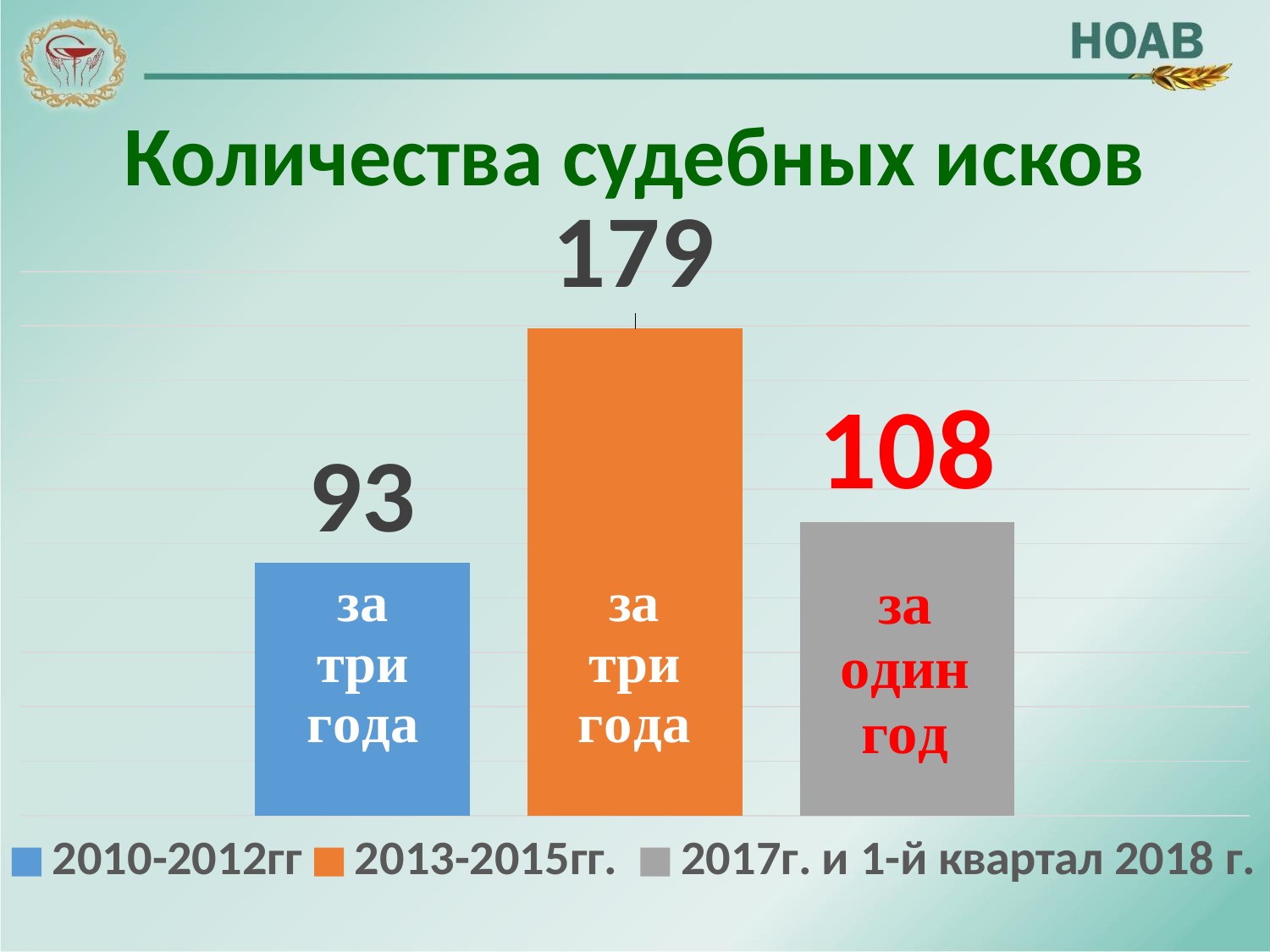
What is the value for 2013-2015гг.? 179 What is the value for 2017г. и 1-й квартал 2018 г.? 108 What is the difference between the values for 2017г. и 1-й квартал 2018 г. and 2010-2012гг? 15 Which is larger, the value for 2010-2012гг or the value for 2017г. и 1-й квартал 2018 г.? 2017г. и 1-й квартал 2018 г. How many entries does the legend list? 3 How many bars are shown in the chart? 3 Which period has the lowest number of lawsuits? 2010-2012гг What is the title of the chart? Количества судебных исков What is the value for 2010-2012гг? 93 What is the difference between the values for 2013-2015гг. and 2010-2012гг? 86 What kind of chart is shown on the slide? bar chart Which period has the highest number of lawsuits? 2013-2015гг.